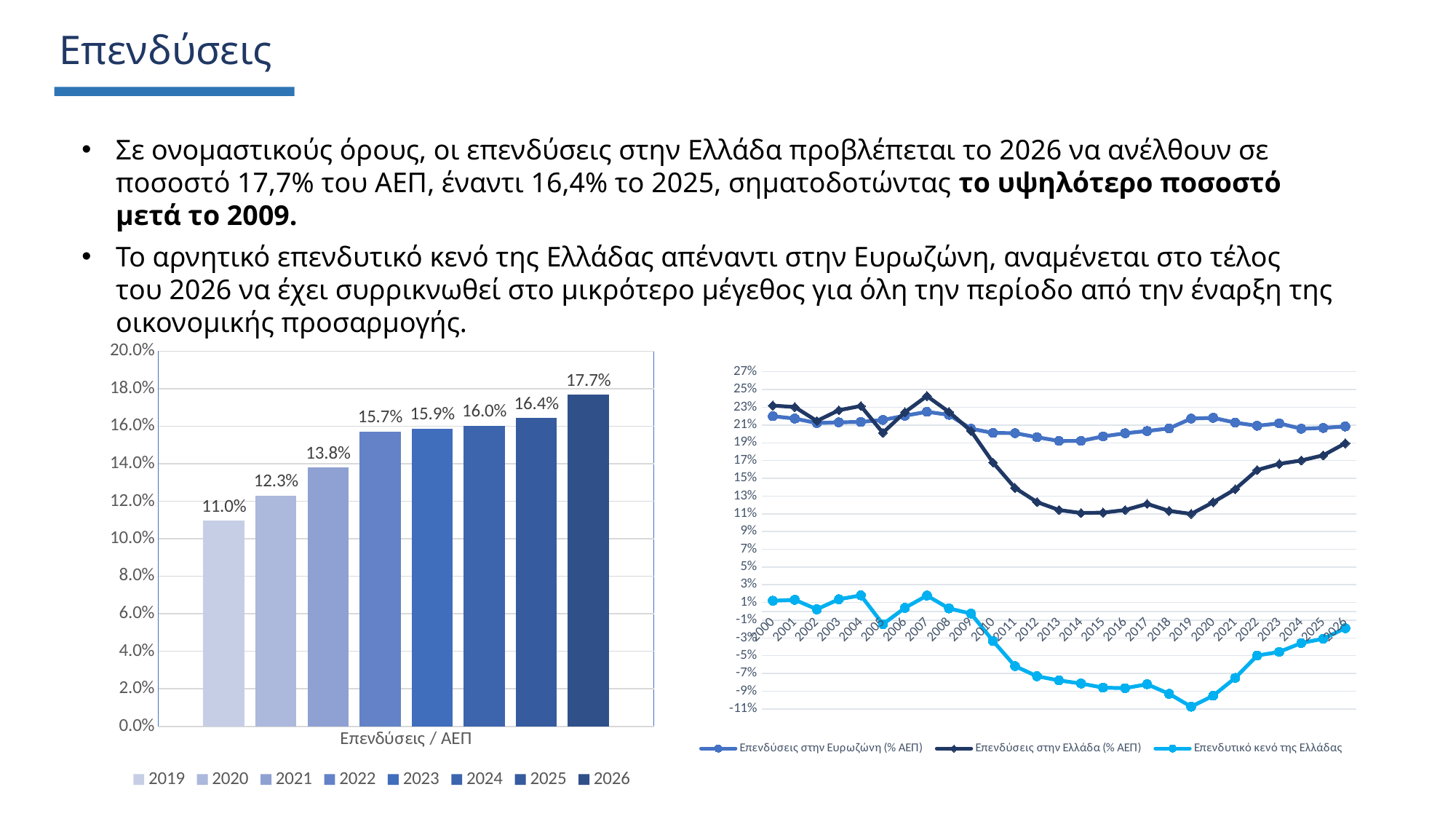
In the left bar chart (Επενδύσεις / ΑΕΠ), what is the difference between the 2026 and 2025 values? 1.3% In the left bar chart (Επενδύσεις / ΑΕΠ), which year has the highest value? 2026 In the left bar chart (Επενδύσεις / ΑΕΠ), how many bars are plotted? 8 In the right-hand line chart, is the value of Επενδύσεις στην Ελλάδα (% ΑΕΠ) in 2019 greater or less than 13%? less In the left bar chart (Επενδύσεις / ΑΕΠ), which year has the lowest value? 2019 In the left bar chart (Επενδύσεις / ΑΕΠ), what is the difference between the 2020 and 2019 values? 1.3% In the left bar chart (Επενδύσεις / ΑΕΠ), what is the value for 2026? 17.7% In the right-hand line chart, is the value of Επενδυτικό κενό της Ελλάδας in 2019 greater or less than -9%? less In the left bar chart (Επενδύσεις / ΑΕΠ), do the values rise or fall from 2019 to 2026? rise How many series does the legend of the right-hand line chart list? 3 What kind of chart is the chart on the left of the slide? bar chart In the left bar chart (Επενδύσεις / ΑΕΠ), what is the value for 2021? 13.8%